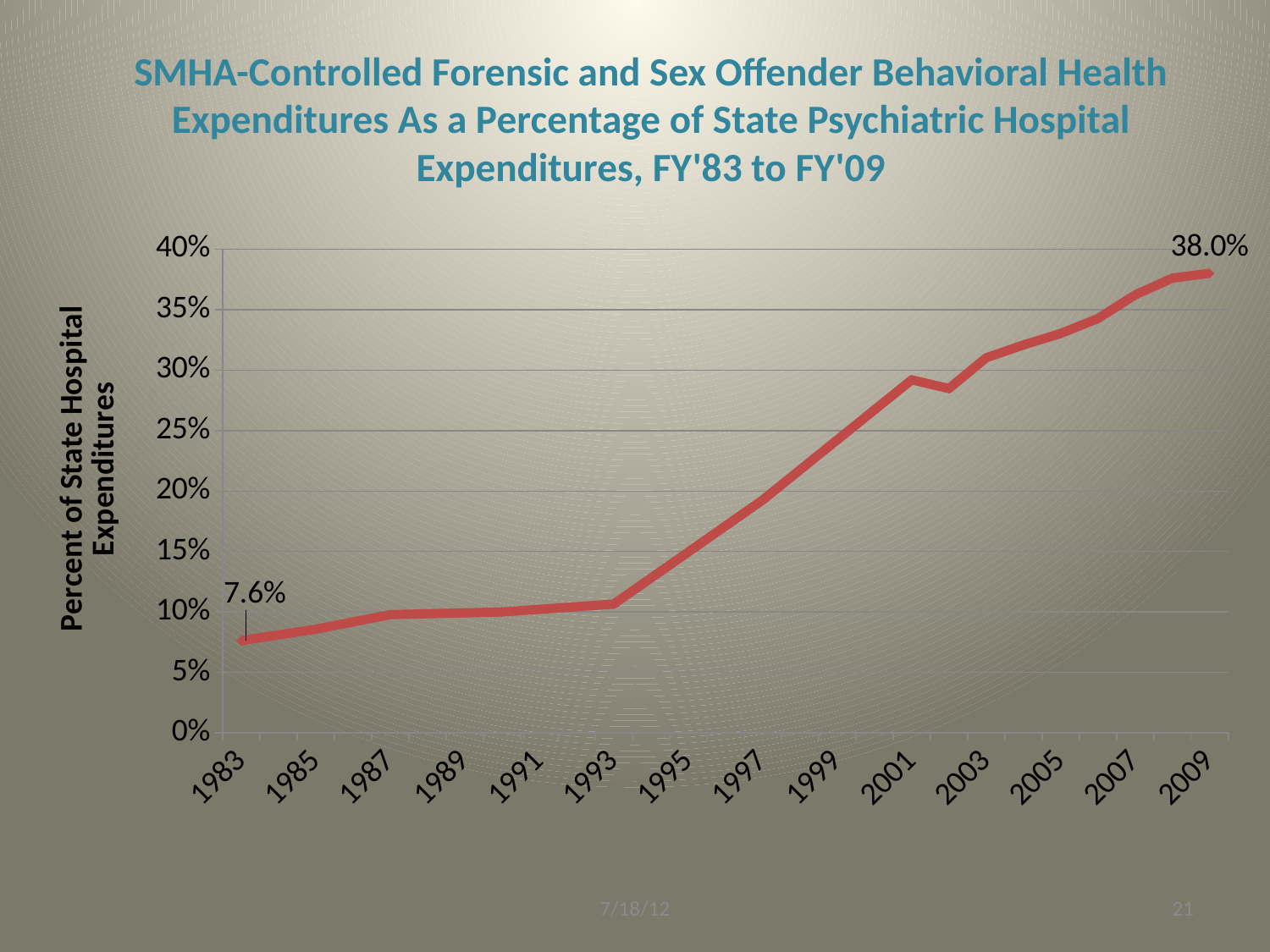
Is the value for 2005 greater or less than 30%? greater Which is larger, the value for 1983 or the value for 2009? 2009 Is the value for 1997 greater or less than 20%? less Which year has the lowest value? 1983 What kind of chart is shown on the slide? line chart What is the difference between the 2009 value and the 1983 value? 30.4 percentage points What is the label on the vertical axis? Percent of State Hospital Expenditures Which year has the highest value? 2009 Is the value for 2001 greater or less than 25%? greater Do the values generally rise or fall from 1983 to 2009? rise What is the value for 1983? 7.6% What is the value for 2009? 38.0%